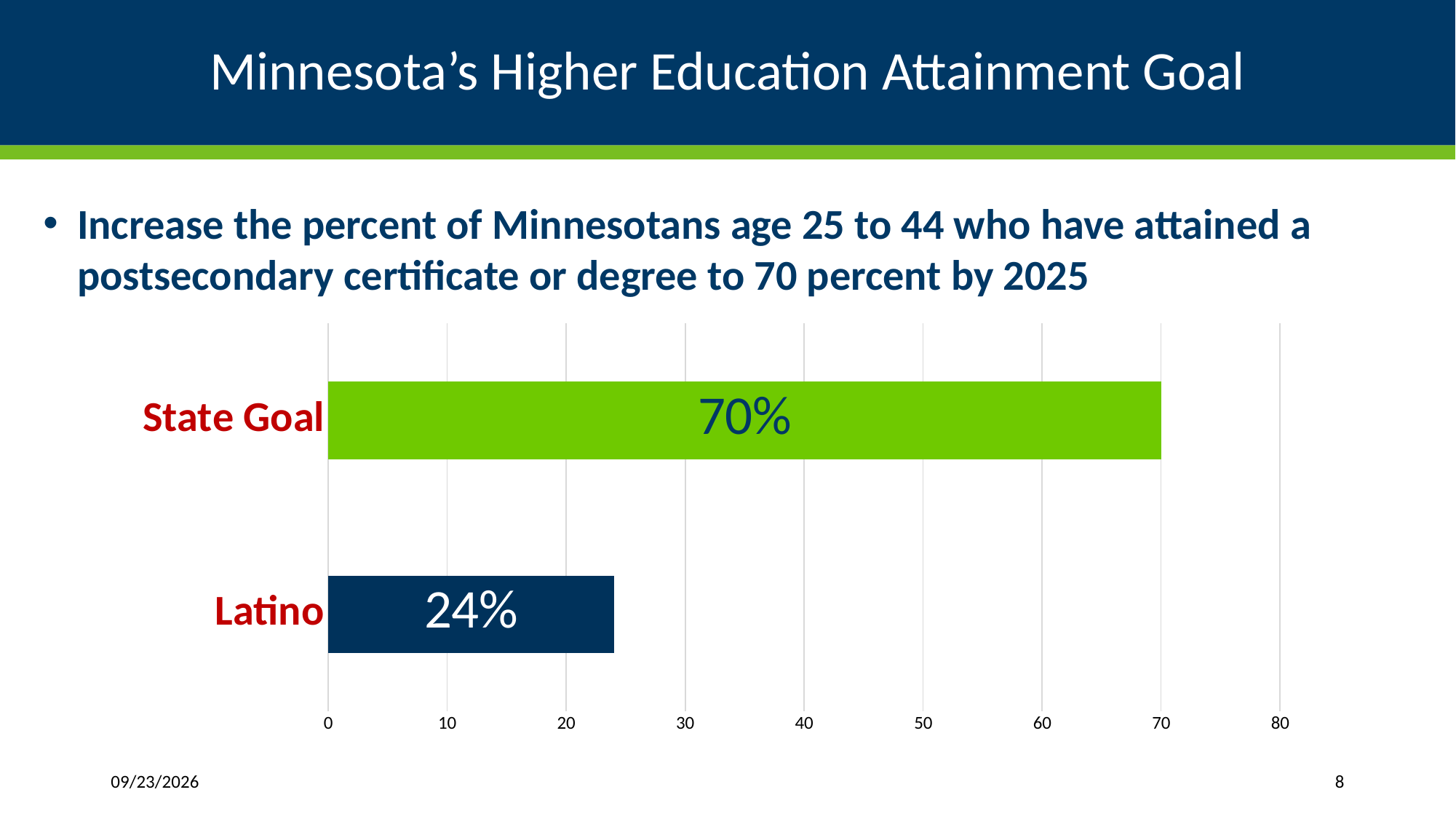
Which category has the lowest value? Latino What colour is the State Goal bar? Green What is the value for Latino? 24% What kind of chart is shown on the slide? Bar chart Is the value for State Goal greater or less than 60? greater How many categories are shown in the chart? 2 Which is larger, the value for State Goal or the value for Latino? State Goal What is the highest tick value shown on the horizontal axis? 80 What is the difference between the State Goal value and the Latino value? 46% Is the value for Latino greater or less than 30? less What is the value for State Goal? 70% Which category has the highest value? State Goal